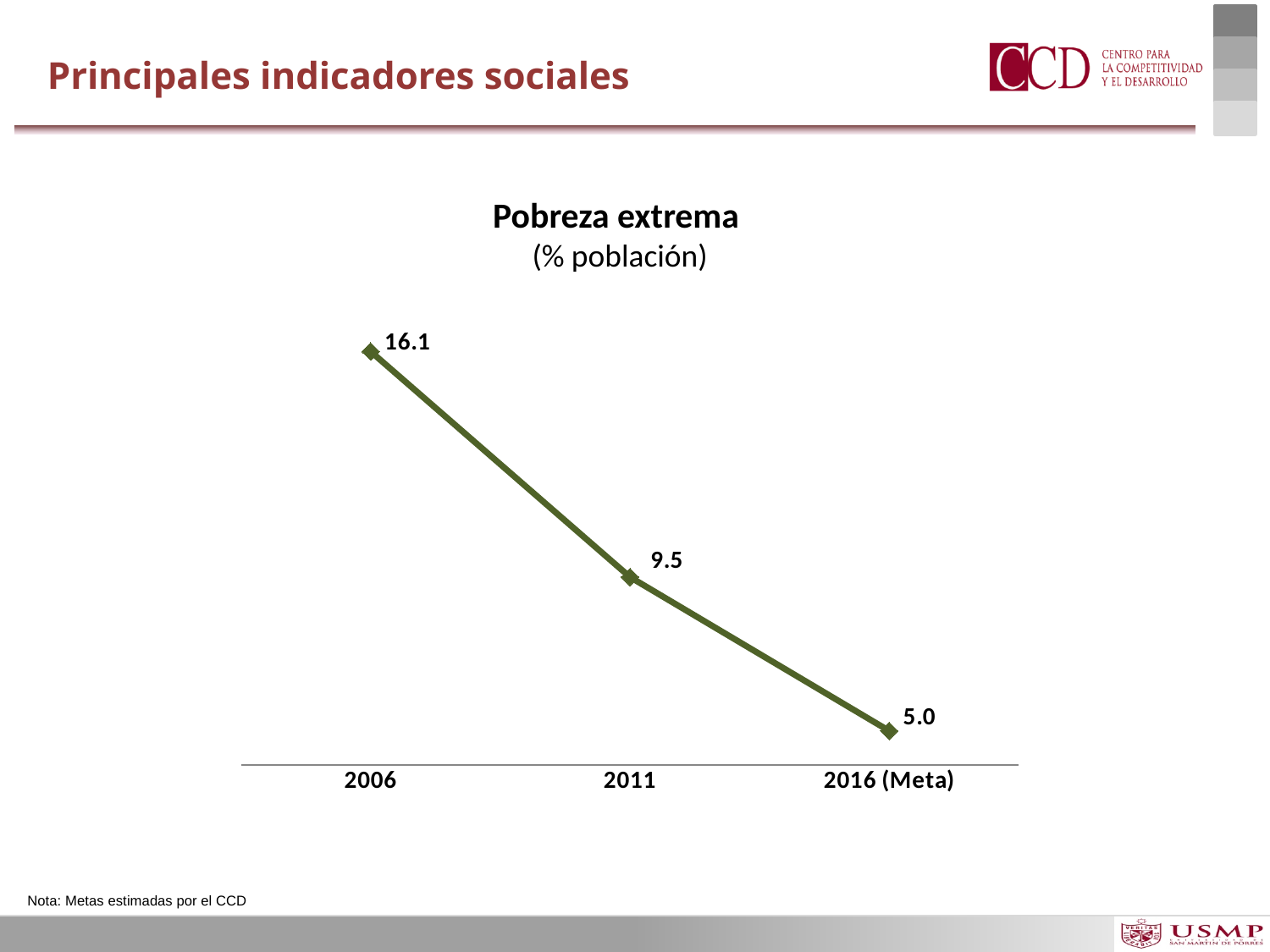
What is the difference between the 2011 and 2016 (Meta) values? 4.5 What kind of chart is shown on the slide? Line chart Which is larger, the value for 2006 or the value for 2011? 2006 What is the difference between the 2006 and 2011 values? 6.6 What is the extreme poverty value for 2011? 9.5 What is the extreme poverty value for 2016 (Meta)? 5.0 Do the values rise or fall from 2006 to 2016 (Meta)? Fall Which year has the highest extreme poverty value? 2006 Which year has the lowest extreme poverty value? 2016 (Meta) What is the title of the chart? Pobreza extrema What is the extreme poverty value for 2006? 16.1 How many data points are plotted on the chart? 3